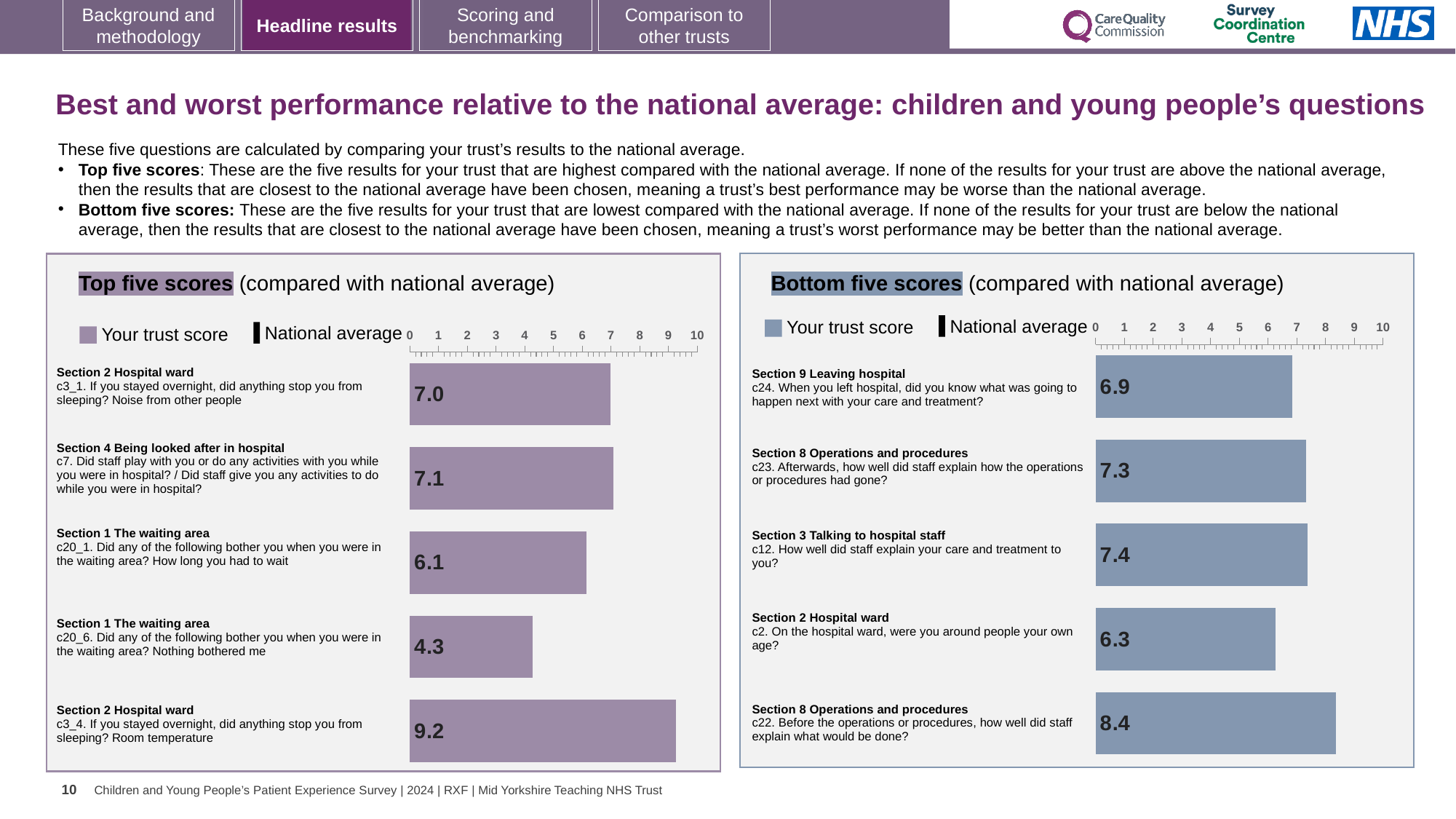
What type of chart is the Top five scores chart? Bar chart In the Bottom five scores chart, which has the larger trust score: c23 (how well did staff explain how the operations had gone) or c24 (did you know what was going to happen next)? c23 In the Top five scores chart, what is the trust score for c20_6 (Nothing bothered me in the waiting area)? 4.3 In the Top five scores chart, is the trust score for c20_1 (How long you had to wait) greater or less than 7? less In the Bottom five scores chart, what is the trust score for c2 (On the hospital ward, were you around people your own age?)? 6.3 In the Top five scores chart, which question has the highest trust score? c3_4 (Room temperature) In the Bottom five scores chart, what is the trust score for c12 (How well did staff explain your care and treatment to you?)? 7.4 In the Top five scores chart, what is the trust score for c3_4 (If you stayed overnight, did anything stop you from sleeping? Room temperature)? 9.2 In the Bottom five scores chart, which question has the lowest trust score? c2 (around people your own age) In the Top five scores chart, what is the difference between the trust scores for c3_4 (9.2) and c20_6 (4.3)? 4.9 How many questions are shown in the Bottom five scores chart? 5 In the Bottom five scores chart, what is the difference between the trust scores for c22 and c24? 1.5